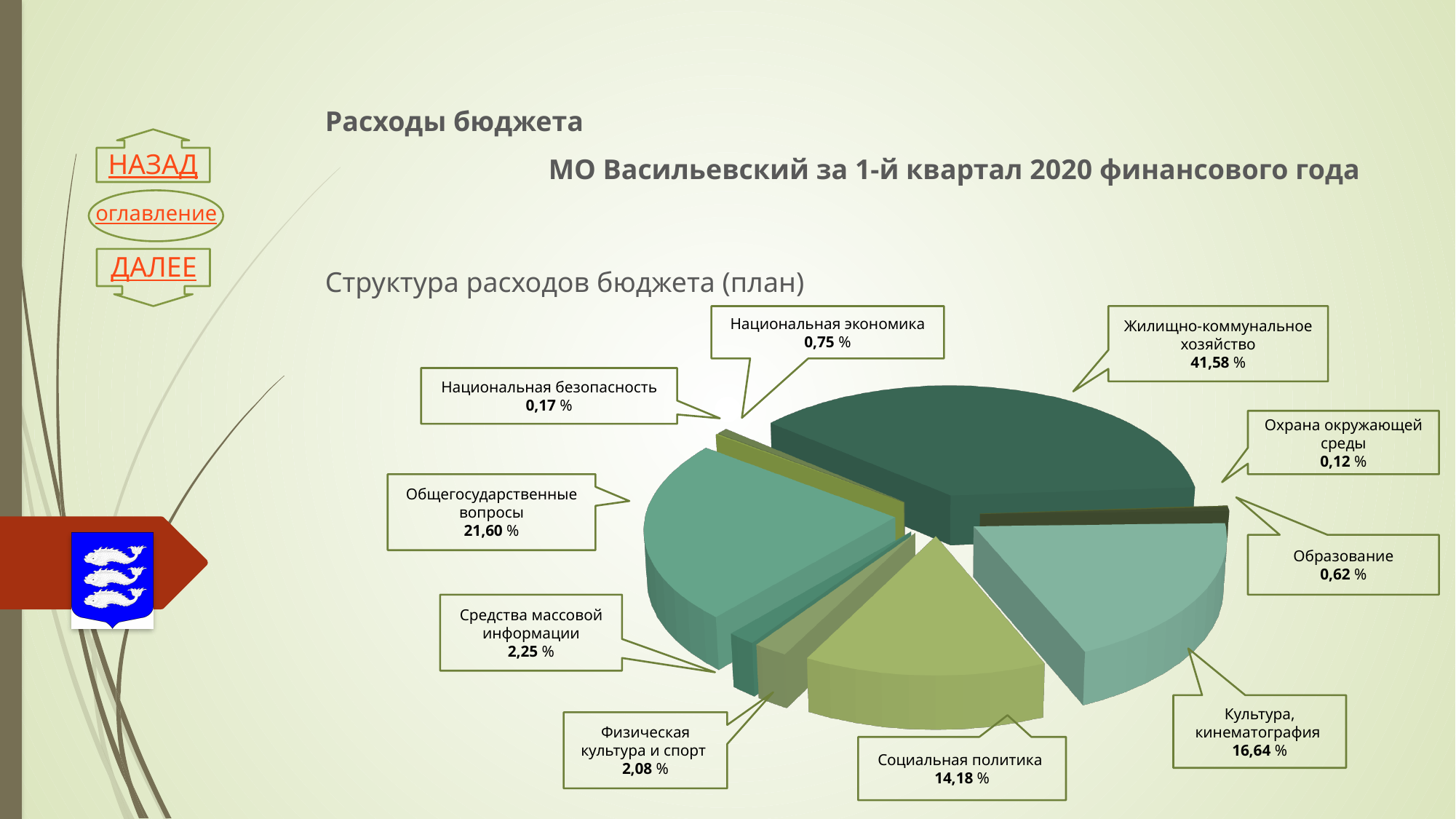
What is the value for Охрана окружающей среды? 0,12 % Which category has the smallest share of the pie? Охрана окружающей среды What is the difference between the shares of Общегосударственные вопросы and Культура, кинематография? 4,96 % What is the value shown for Общегосударственные вопросы? 21,60 % What share of the pie does Жилищно-коммунальное хозяйство have? 41,58 % What type of chart is shown on the slide? Pie chart What is the title of the chart? Структура расходов бюджета (план) Which category has the largest share of the pie? Жилищно-коммунальное хозяйство What percentage is labelled for Социальная политика? 14,18 % How many categories are shown in the pie chart? 10 Which is larger: the share of Средства массовой информации or Физическая культура и спорт? Средства массовой информации What is the difference between the shares of Национальная экономика and Национальная безопасность? 0,58 %